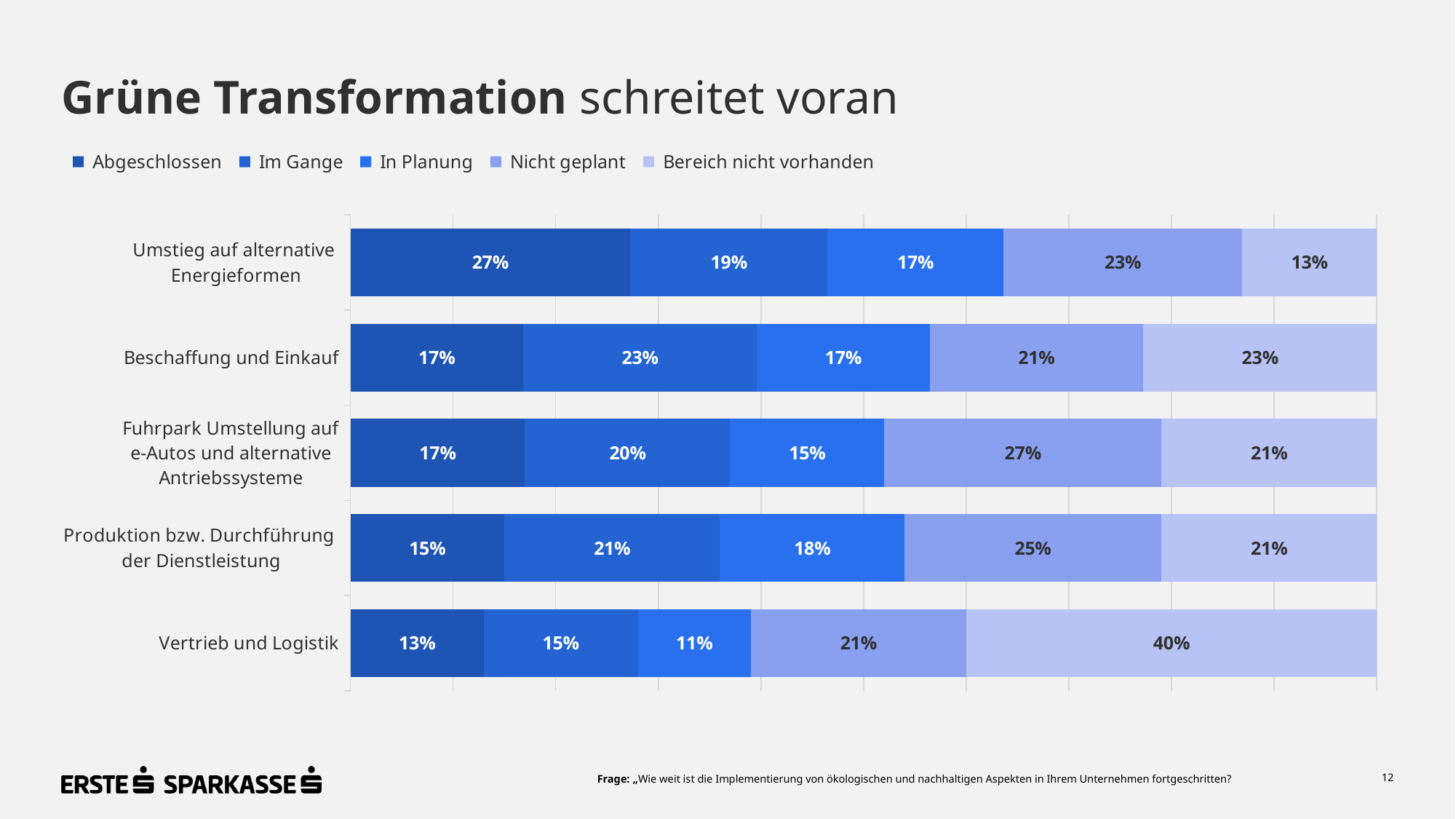
What kind of chart is shown on the slide? Stacked bar chart Which category has the highest 'Abgeschlossen' value? Umstieg auf alternative Energieformen What is the 'Im Gange' value for 'Beschaffung und Einkauf'? 23% What is the 'Abgeschlossen' value for 'Umstieg auf alternative Energieformen'? 27% What is the difference between the 'Bereich nicht vorhanden' values for 'Vertrieb und Logistik' and 'Umstieg auf alternative Energieformen'? 27% What is the 'Bereich nicht vorhanden' value for 'Vertrieb und Logistik'? 40% What is the total of the stacked bar for 'Beschaffung und Einkauf'? 101% Which is larger: the 'Im Gange' value for 'Produktion bzw. Durchführung der Dienstleistung' or for 'Vertrieb und Logistik'? Produktion bzw. Durchführung der Dienstleistung How many categories are shown on the chart? 5 Which category has the lowest 'In Planung' value? Vertrieb und Logistik How many series does the legend list? 5 What is the 'Nicht geplant' value for 'Fuhrpark Umstellung auf e-Autos und alternative Antriebssysteme'? 27%